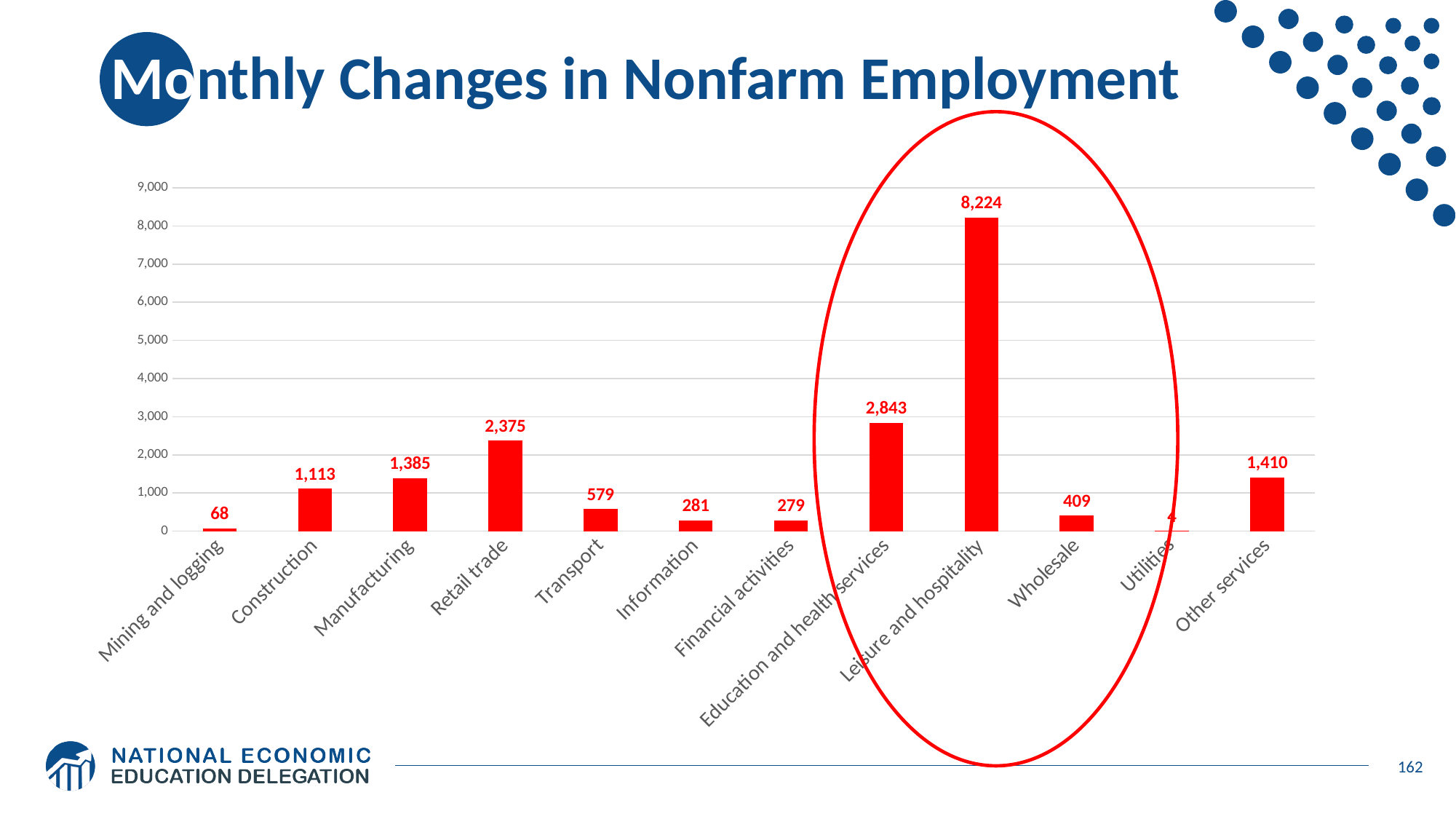
What is the title of the slide? Monthly Changes in Nonfarm Employment Which is larger, the value for Construction or the value for Manufacturing? Manufacturing What is the value for Retail trade? 2,375 What is the value for Mining and logging? 68 Is the value for Education and health services greater or less than 2,000? greater How many categories are shown on the x axis? 12 What type of chart is shown on the slide? Bar chart What is the difference between the values for Leisure and hospitality and Education and health services? 5,381 What is the value for Other services? 1,410 What is the value for Leisure and hospitality? 8,224 Which category has the highest value? Leisure and hospitality Which category has the lowest value? Utilities